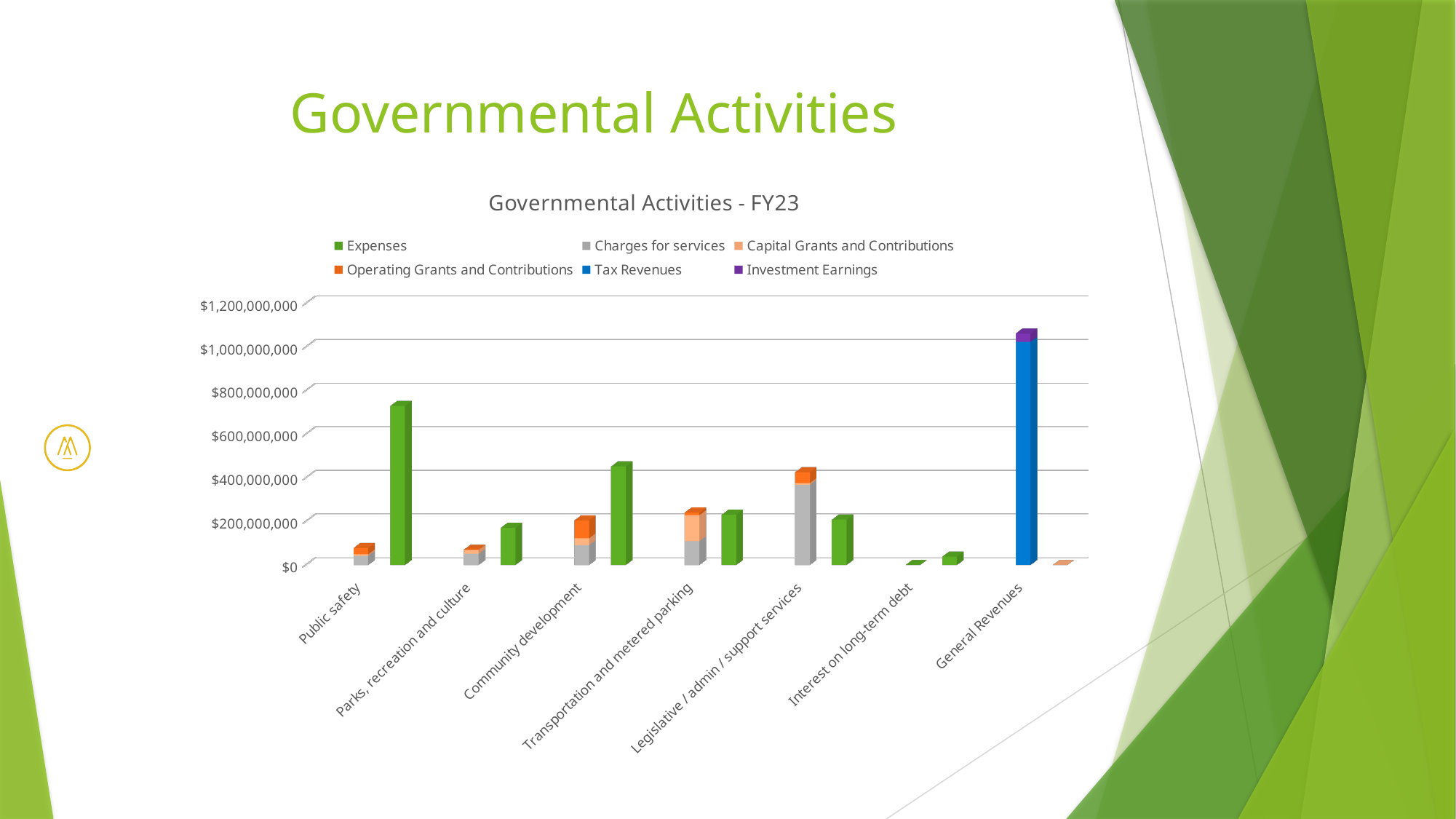
Which category has the highest Expenses bar? Public safety How many categories are shown along the x axis? 7 Is the Expenses value for Community development greater or less than $200,000,000? greater Is the Expenses value for Public safety greater or less than $600,000,000? greater Is the Expenses value for Parks, recreation and culture greater or less than $200,000,000? less Which is larger: the Expenses value for Public safety or the Expenses value for Community development? Public safety Which colour represents Tax Revenues in the legend? blue What kind of chart is shown on the slide? bar chart How many series does the legend list? 6 What is the title of the chart? Governmental Activities - FY23 Which category has the lowest Expenses bar? Interest on long-term debt